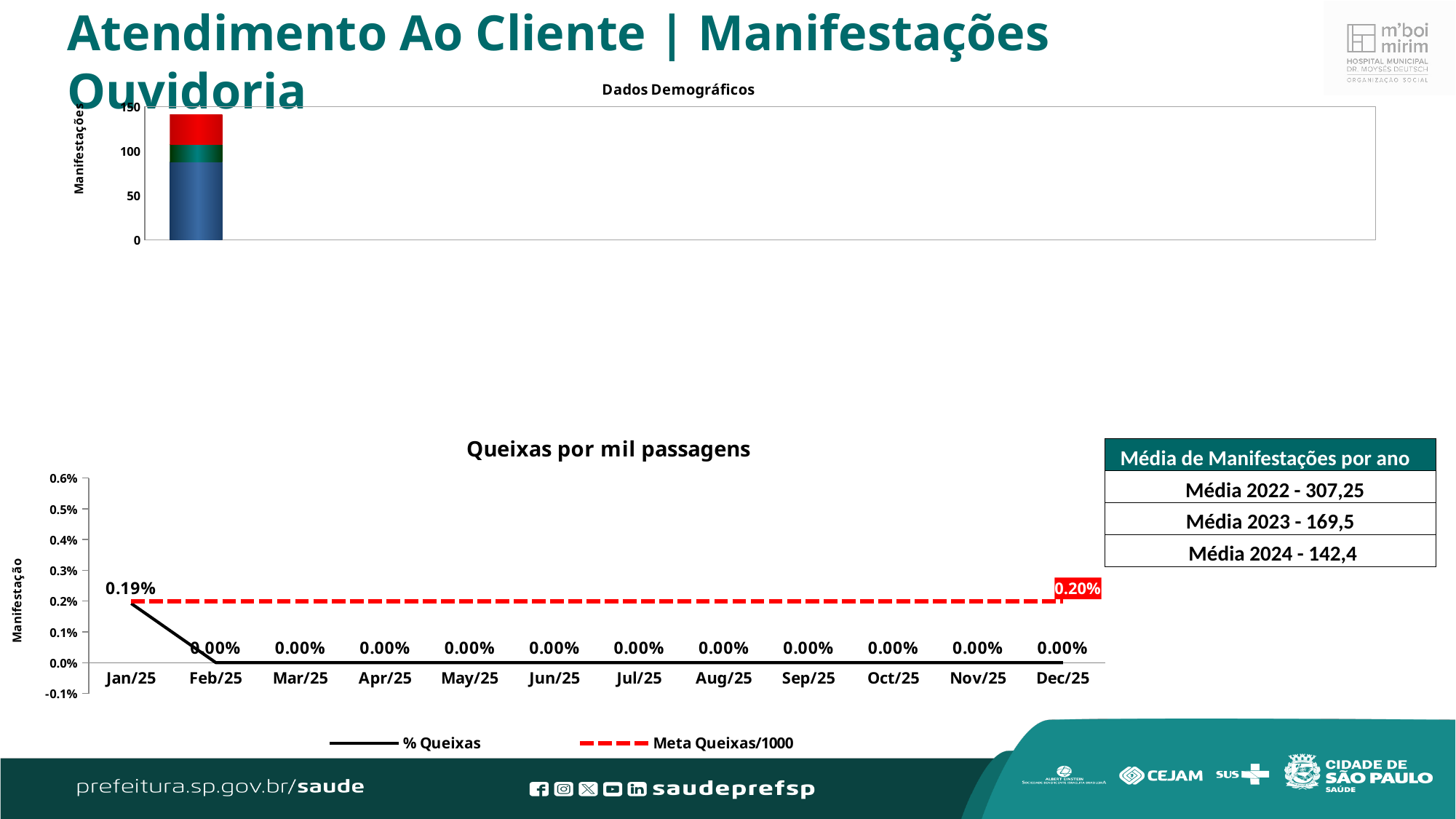
What kind of chart is the 'Dados Demográficos' chart at the top of the slide? bar chart In the 'Queixas por mil passagens' chart, is the % Queixas value for Jan/25 larger or smaller than the value for Feb/25? larger In the 'Queixas por mil passagens' chart, what is the value of the Meta Queixas/1000 line labelled at Dec/25? 0.20% In the 'Queixas por mil passagens' chart, does the % Queixas line rise or fall from Jan/25 to Feb/25? fall In the 'Queixas por mil passagens' chart, what is the difference between the Meta Queixas/1000 value (0.20%) and the Jan/25 % Queixas value? 0.01% In the 'Queixas por mil passagens' chart, what is the % Queixas value for Jun/25? 0.00% In the 'Queixas por mil passagens' chart, which month has the highest % Queixas value? Jan/25 How many series does the legend of the 'Queixas por mil passagens' chart list? 2 What kind of chart is the 'Queixas por mil passagens' chart? line chart In the 'Queixas por mil passagens' chart, what is the % Queixas value for Jan/25? 0.19% In the 'Queixas por mil passagens' chart, how many months are shown on the x axis? 12 In the 'Dados Demográficos' chart, is the total height of the stacked bar greater or less than 100? greater